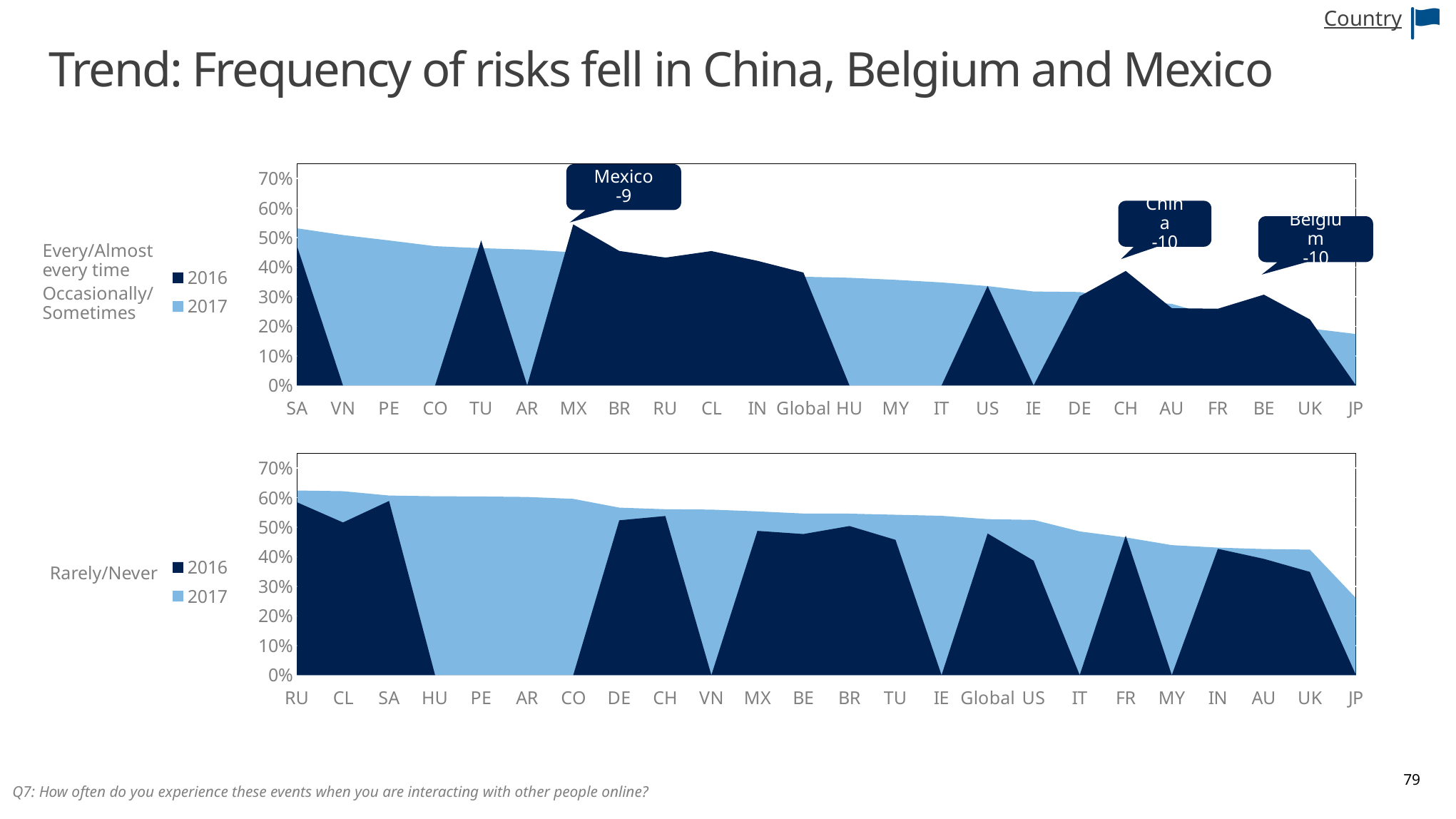
How many countries/categories are shown on the x axis of the top chart? 24 In the top chart, is the 2017 value for SA greater or less than 50%? greater In the top chart, what change does the callout for Mexico show? -9 In the top chart, which colour represents the 2017 series? Light blue What kind of chart is the top chart (Every/Almost every time, Occasionally/Sometimes)? Area chart In the bottom chart (Rarely/Never), is the 2017 value for JP greater or less than 40%? less In the top chart, which category has the highest 2017 value? SA In the top chart, which category has the lowest 2017 value? JP How many series does the legend of the bottom chart (Rarely/Never) list? 2 In the bottom chart (Rarely/Never), which category has the highest 2017 value? RU In the bottom chart (Rarely/Never), is the 2017 value for RU greater or less than 60%? greater In the top chart, do the 2017 values rise or fall moving from left to right along the x axis? fall